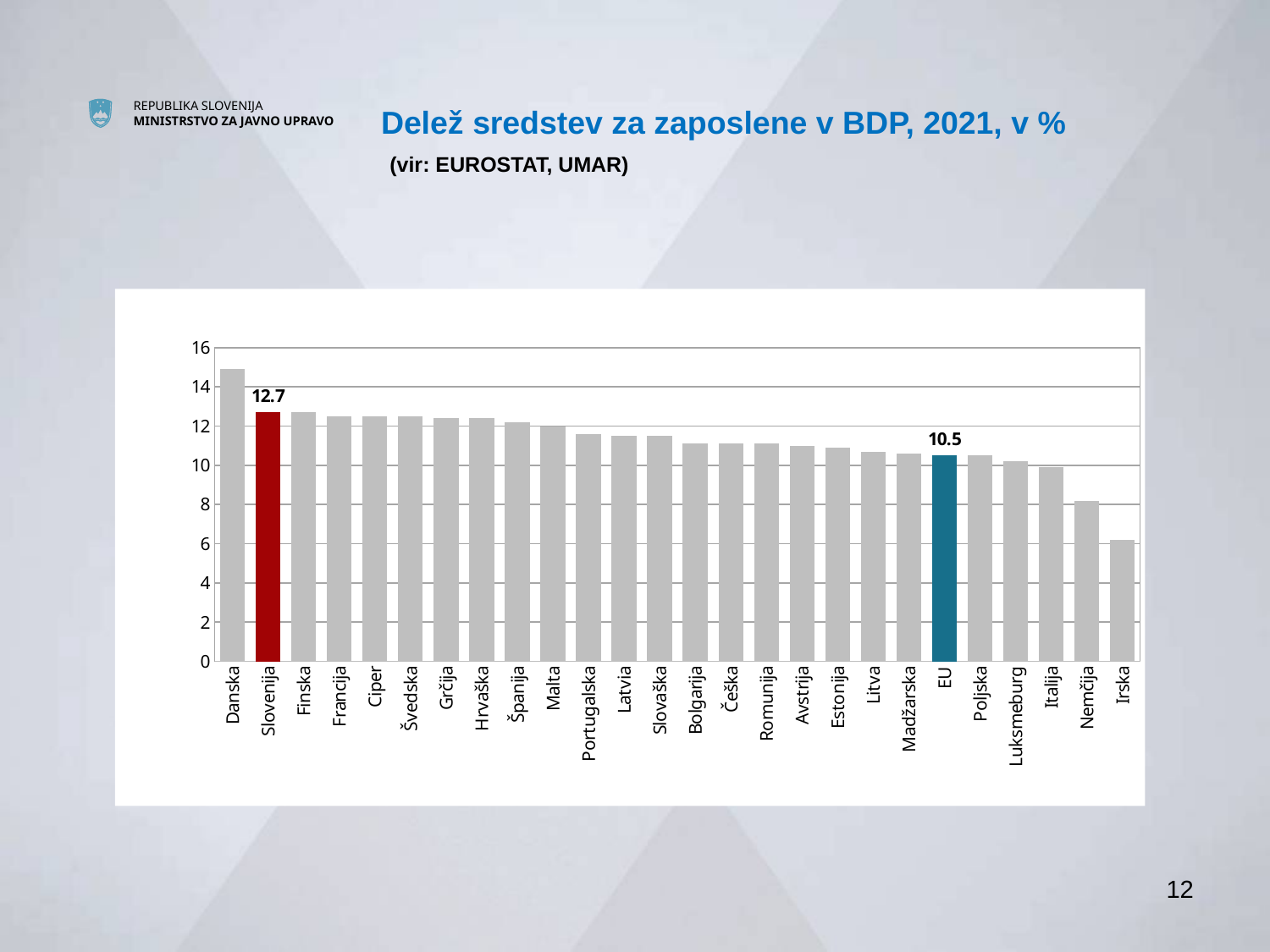
How many bars are shown in the chart? 26 What is the value for EU? 10.5 Which country has the lowest value? Irska What is the value for Slovenija? 12.7 Which country has the highest value? Danska Which is larger, the value for Danska or the value for Irska? Danska What kind of chart is shown on the slide? Bar chart Is the value for Nemčija greater or less than 10? less What is the difference between the values for Slovenija and EU? 2.2 Do the values generally rise or fall from left to right along the x axis? Fall Is the value for Danska greater or less than 14? greater Is the value for Irska greater or less than 8? less